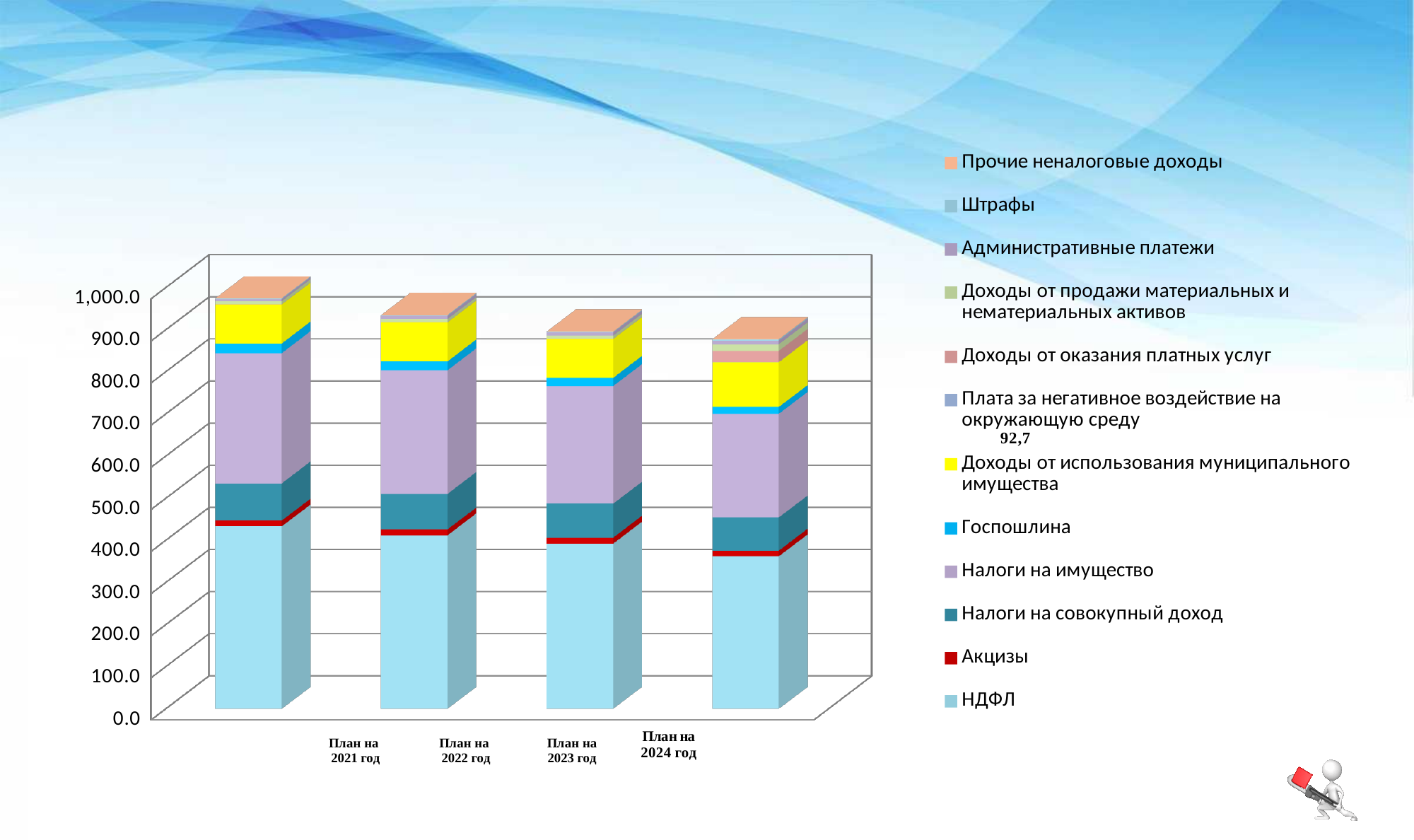
How many bars (plan years) are shown on the chart? 4 How many series does the legend list? 12 Which series is shown in yellow in the legend? Доходы от использования муниципального имущества Which series is listed last (at the bottom) in the legend? НДФЛ What kind of chart is shown on the slide? stacked bar chart Is the total height of the bar for План на 2024 год greater or less than 1,000.0? less